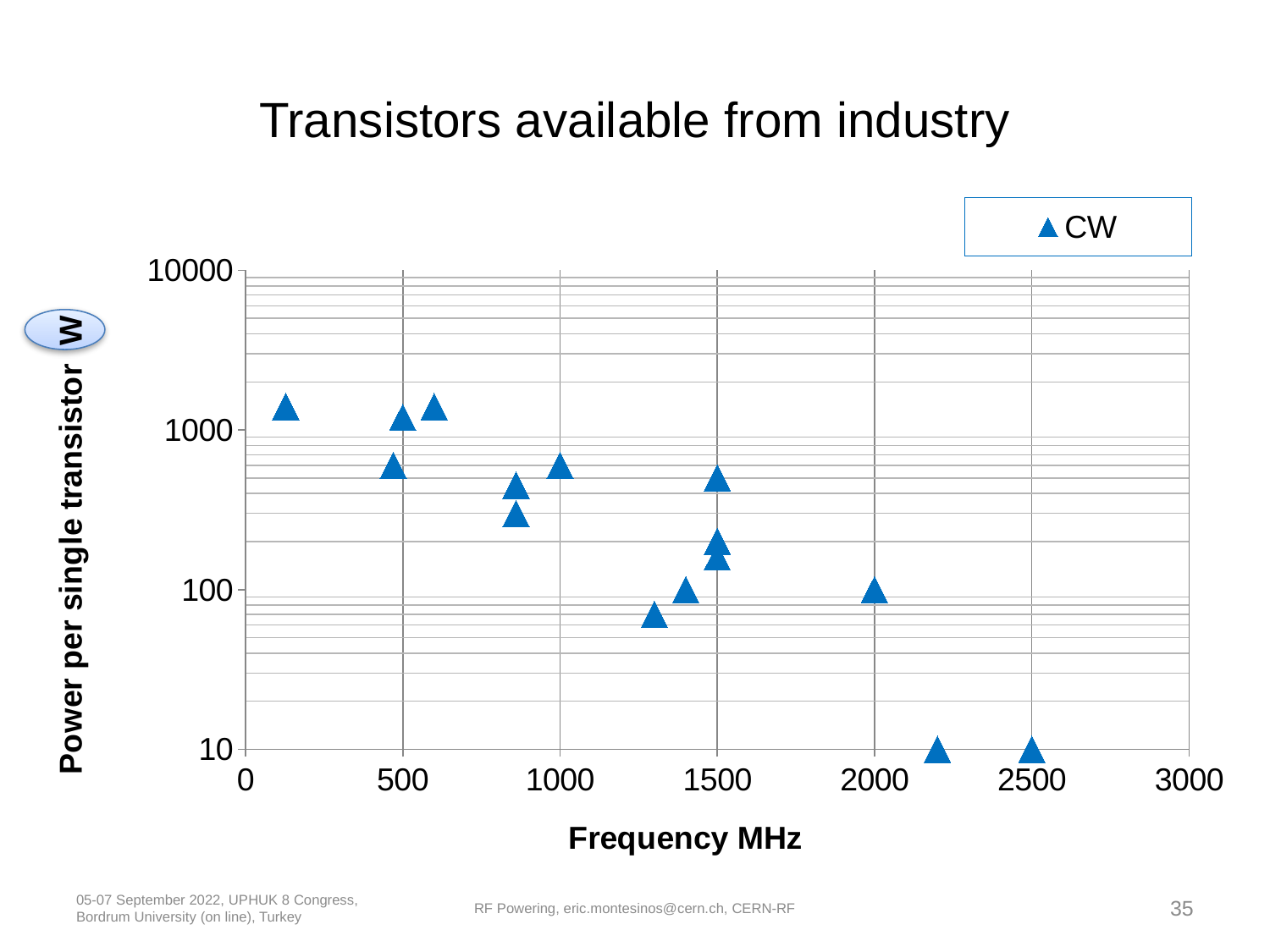
What is the title of the chart? Transistors available from industry What is the name of the series shown in the legend? CW Which has the higher power per transistor: the point at 600 MHz or the point at 2000 MHz? 600 MHz Is the power value for the point at 2500 MHz greater or less than 100 W? less Is the power value for the point at 1300 MHz greater or less than 100 W? less How many data points are plotted on the chart? 15 Overall, does the power per single transistor rise or fall as frequency increases? fall Is the power value for the point at 1000 MHz greater or less than 100 W? greater What kind of chart is shown on the slide? scatter chart How many series does the legend list? 1